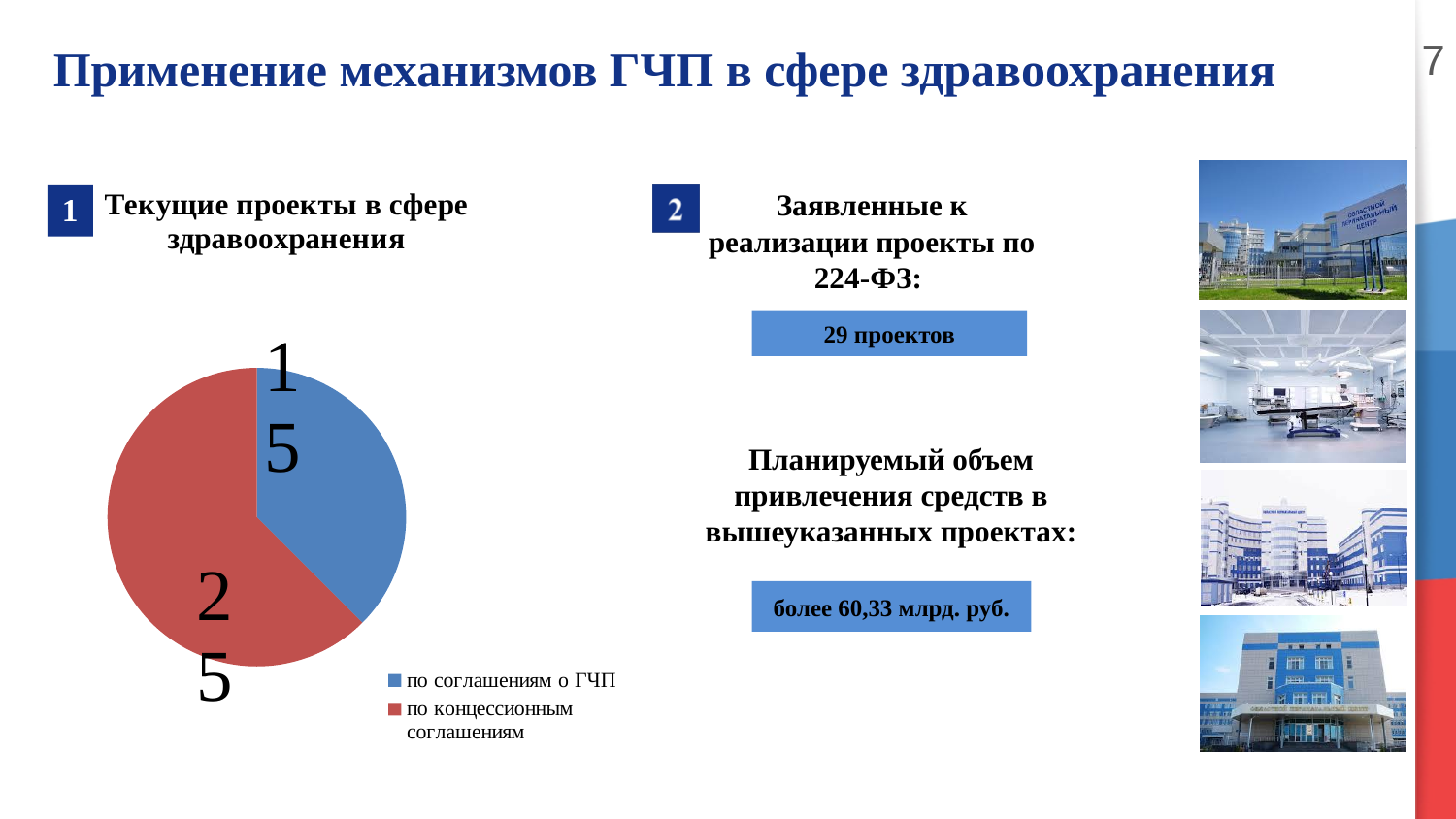
What is the value for "по концессионным соглашениям" in the pie chart? 25 Which category has the smallest slice in the pie chart? по соглашениям о ГЧП What is the total of the two values shown in the pie chart? 40 What colour is the slice for "по соглашениям о ГЧП" in the pie chart? blue Which is larger: the value for "по соглашениям о ГЧП" or for "по концессионным соглашениям"? по концессионным соглашениям What is the value for "по соглашениям о ГЧП" in the pie chart? 15 What kind of chart is shown on the slide? pie chart How many entries does the legend of the pie chart list? 2 Which category has the largest slice in the pie chart? по концессионным соглашениям What is the difference between the values for "по концессионным соглашениям" and "по соглашениям о ГЧП"? 10 How many slices does the pie chart have? 2 What share of the pie does "по концессионным соглашениям" represent? 62.5%